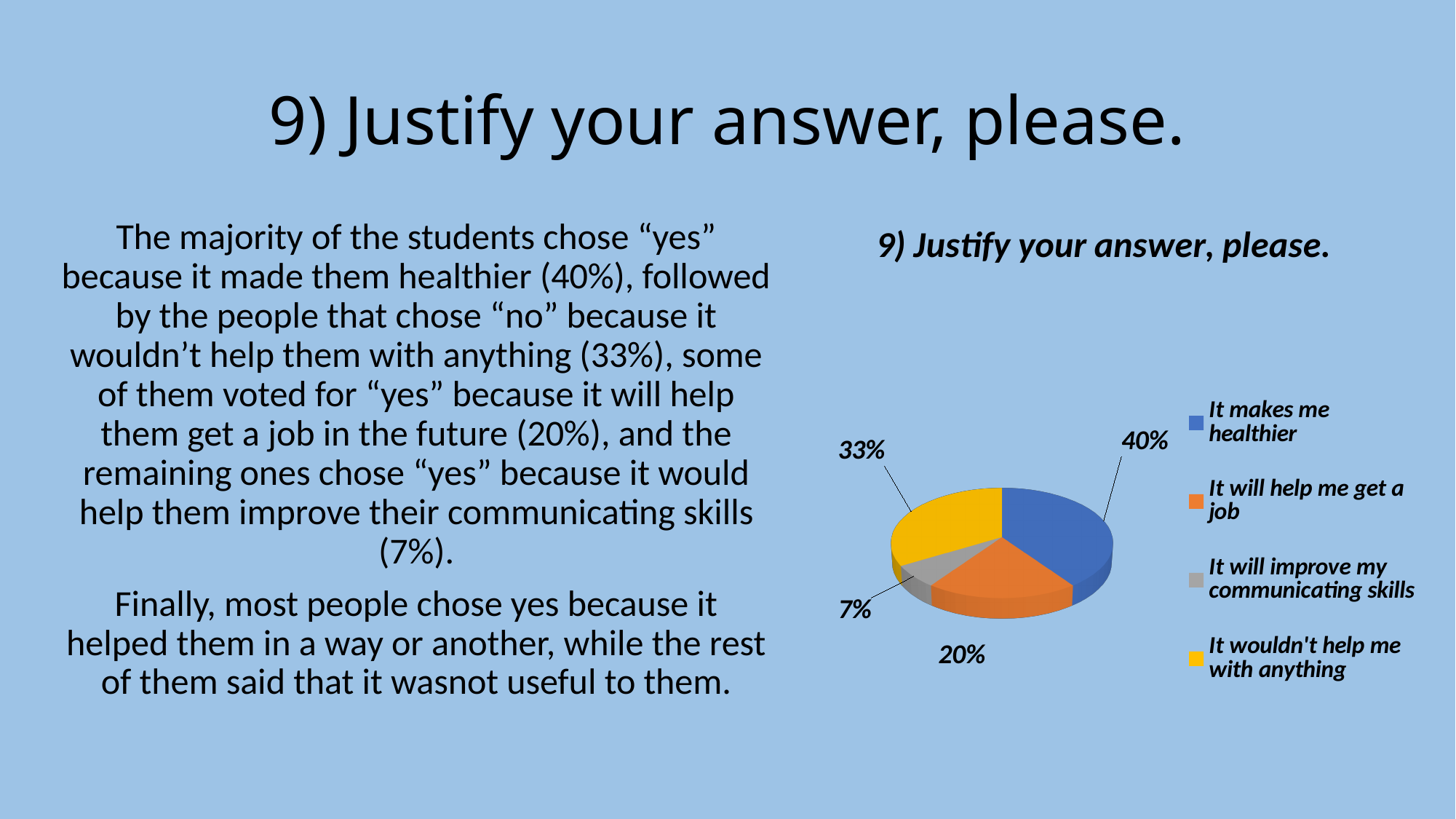
How many categories does the legend list? 4 What percentage of the pie is 'It will help me get a job'? 20% What is the difference in percentage points between 'It makes me healthier' and 'It wouldn't help me with anything'? 7 Which category has the largest share of the pie? It makes me healthier What percentage of the pie is 'It will improve my communicating skills'? 7% What is the title of the chart? 9) Justify your answer, please. What kind of chart is shown on the slide? pie chart Which category has the smallest share of the pie? It will improve my communicating skills What colour is the slice for 'It wouldn't help me with anything'? yellow What percentage of the pie is 'It makes me healthier'? 40% What percentage of the pie is 'It wouldn't help me with anything'? 33% Which is larger: the share for 'It will help me get a job' or the share for 'It will improve my communicating skills'? It will help me get a job